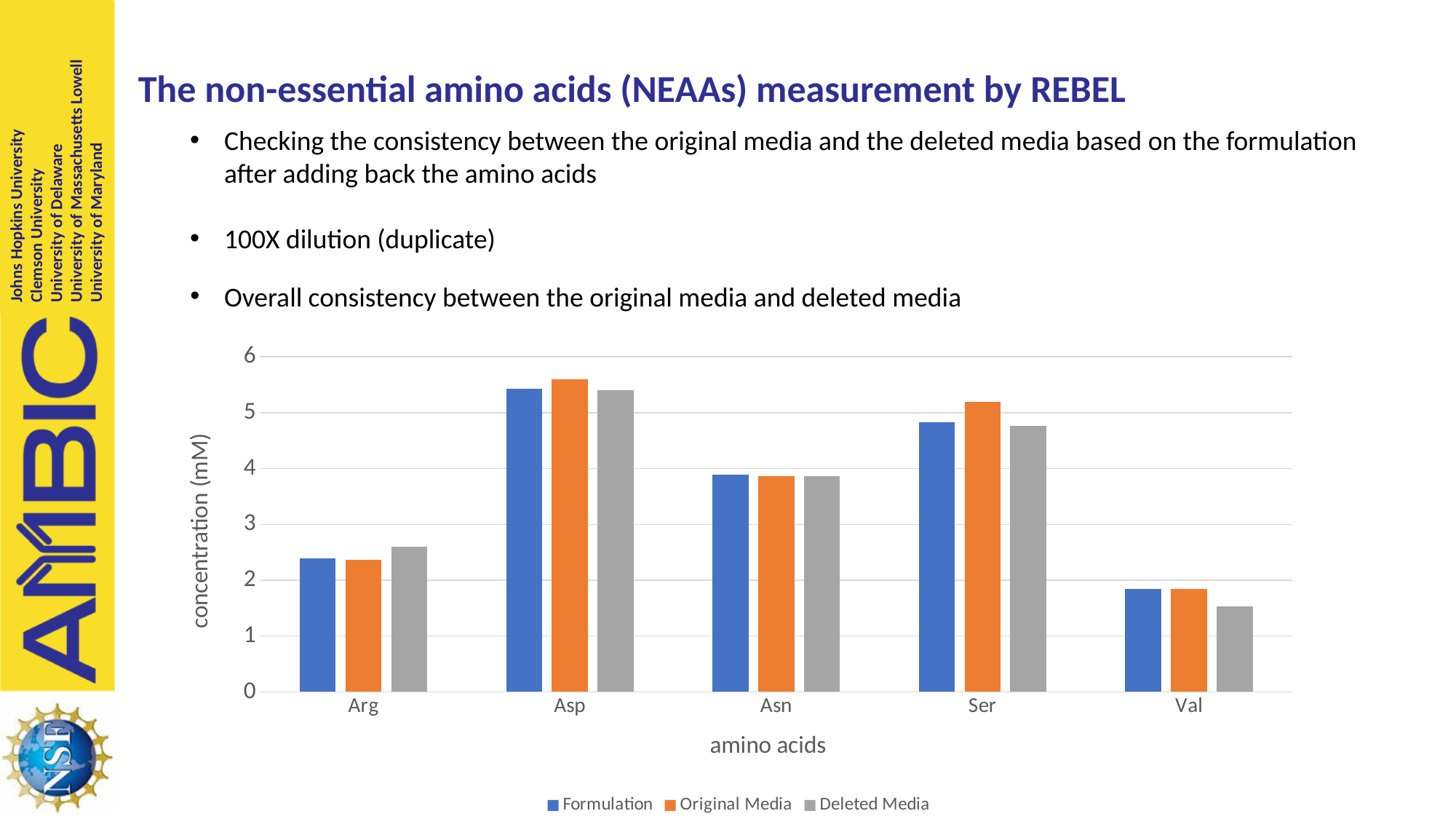
Is the Formulation value for Ser greater or less than 5? less How many amino acid categories are shown on the x axis of the chart? 5 How many series does the chart legend list? 3 Which amino acid has the lowest Formulation concentration? Val Is the Original Media value for Asp greater or less than 5? greater Which amino acid has the highest Original Media concentration? Asp What kind of chart is shown on the slide? bar chart Which amino acid has the lowest Deleted Media concentration? Val Which is larger, the Formulation value for Asp or the Formulation value for Asn? Asp Is the Deleted Media value for Arg greater or less than 2? greater What is the label of the y axis of the chart? concentration (mM)